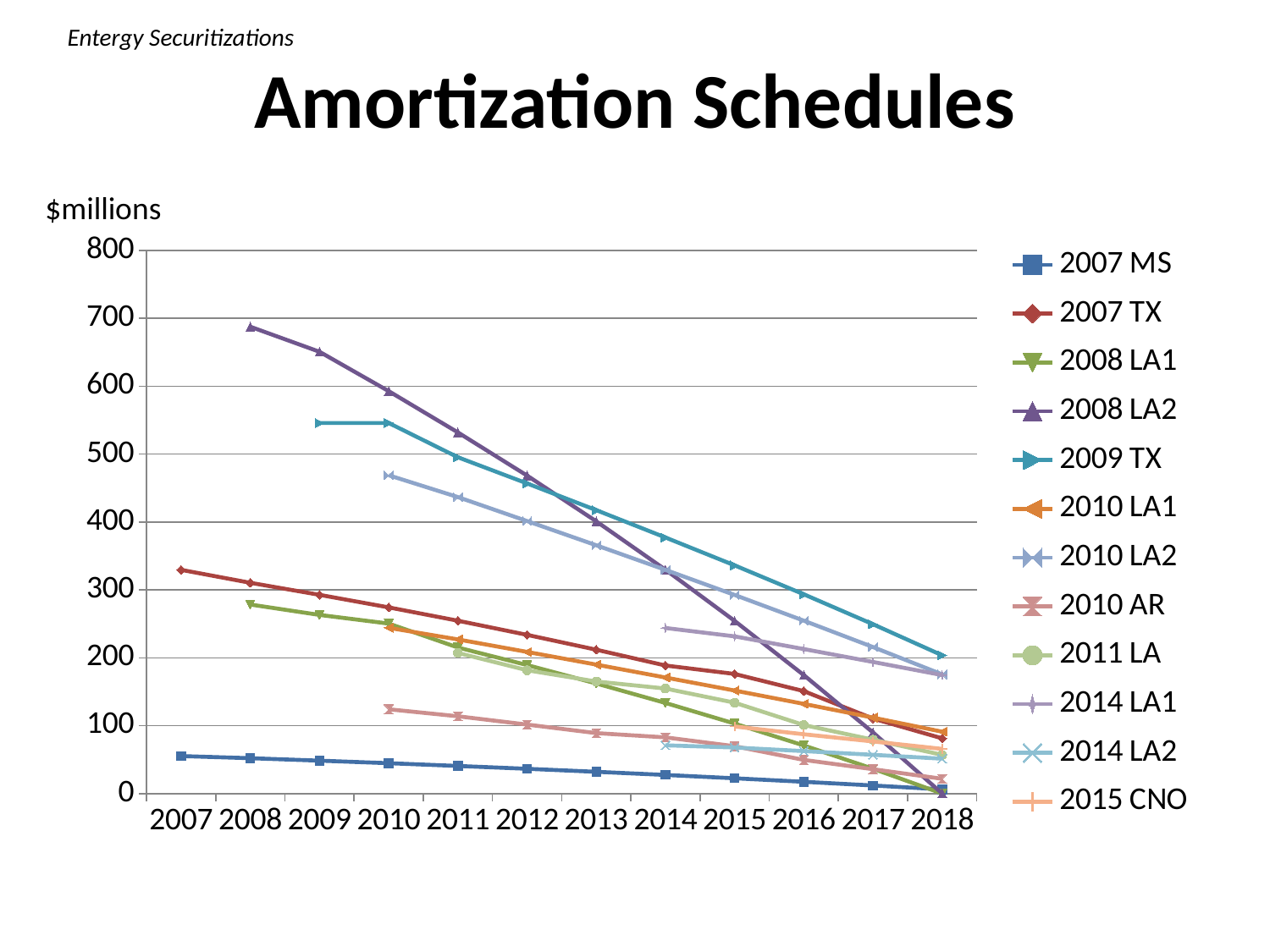
Is the value for 2009 TX in 2009 greater or less than 500? greater How many series does the legend list? 12 Is the value for 2008 LA2 in 2008 greater or less than 600? greater How many years are shown along the x axis? 12 Does the 2007 MS series rise or fall from 2007 to 2018? fall Is the value for 2007 MS in 2007 greater or less than 100? less Which series has the highest value in 2018? 2009 TX Which series has the highest value in 2008? 2008 LA2 What unit is shown for the vertical axis? $millions What is the title of the chart? Amortization Schedules What kind of chart is shown on the slide? line chart